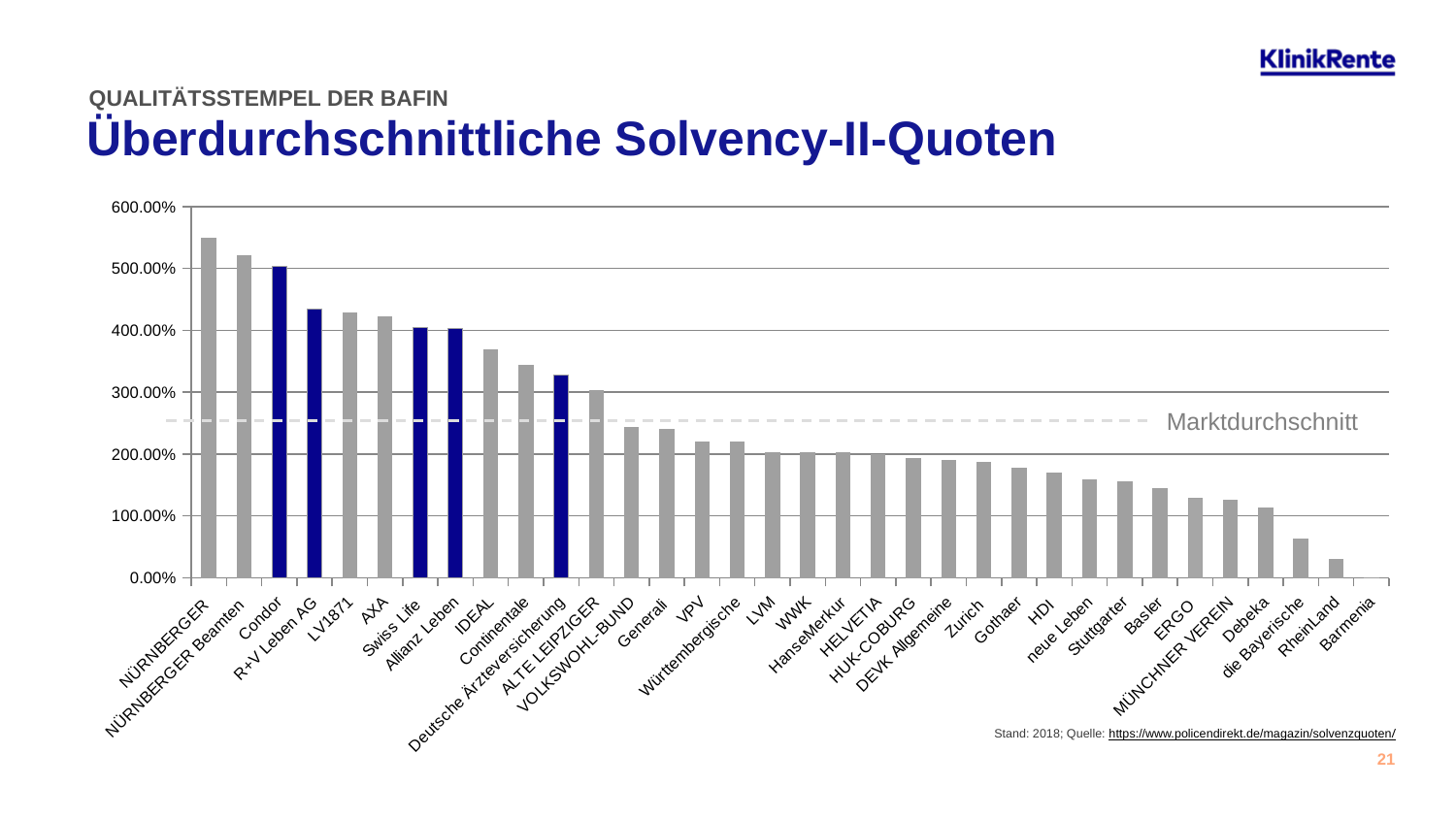
Which company has the highest Solvency-II-Quote in the chart? NÜRNBERGER Is the value for NÜRNBERGER greater or less than 500.00%? greater What does the dashed horizontal line in the chart represent? Marktdurchschnitt Which company has the lowest Solvency-II-Quote in the chart? Barmenia Is the value for HDI greater or less than 200.00%? less Which has the larger value, AXA or Generali? AXA Is the value for LV1871 greater or less than 400.00%? greater Which has the larger value, Debeka or IDEAL? IDEAL Do the values rise or fall from left to right along the x axis? fall What kind of chart is shown on the slide? bar chart